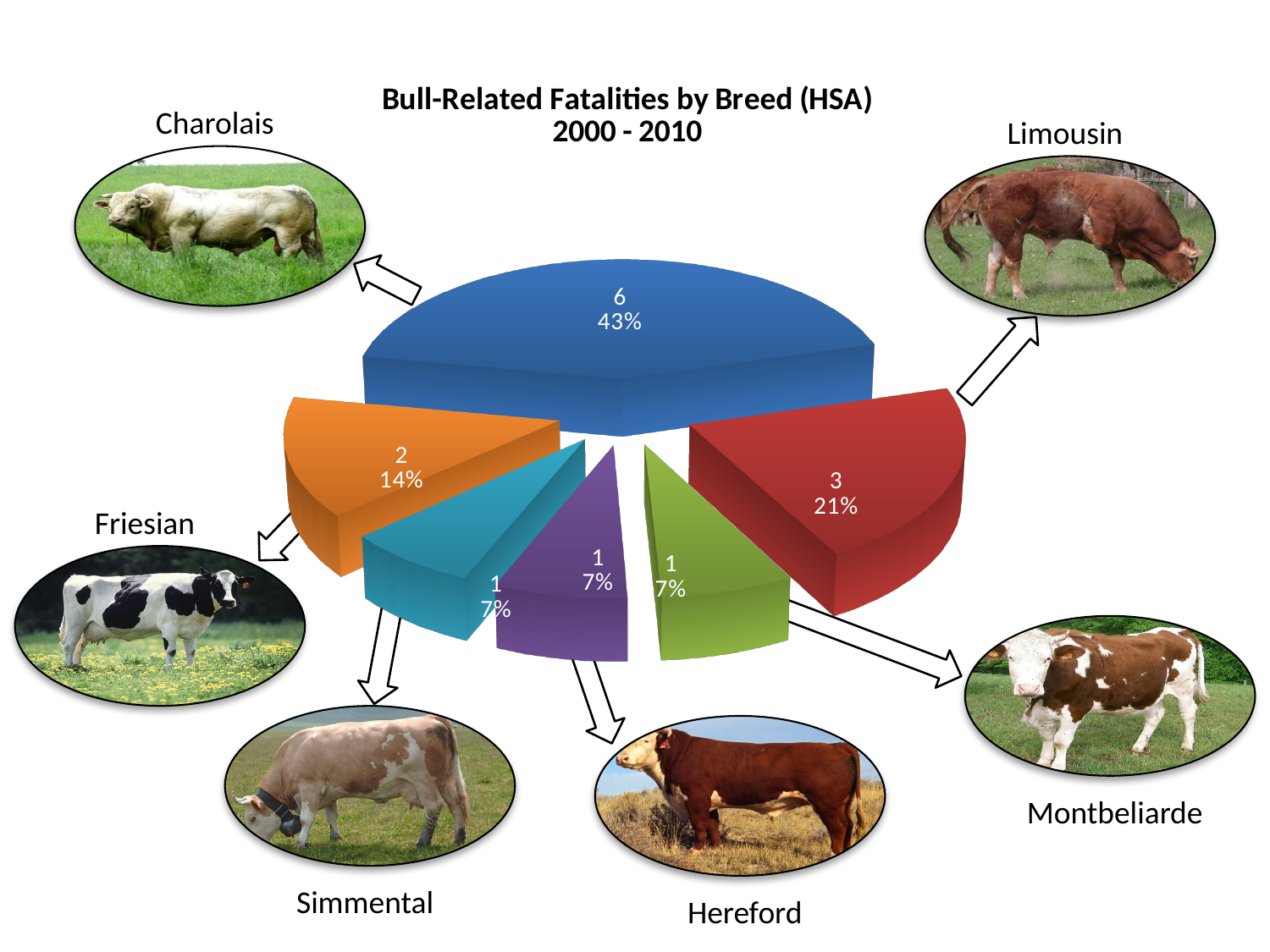
What percentage share of the pie does the Limousin slice represent? 21% How many fatalities are attributed to the Friesian breed? 2 What is the difference in fatalities between Charolais and Limousin? 3 How many fatalities are attributed to the Charolais breed? 6 Which breed has more fatalities, Limousin or Friesian? Limousin How many breeds are shown with 1 fatality (7%)? 3 How many slices does the pie chart have? 6 What is the title of the chart? Bull-Related Fatalities by Breed (HSA) 2000 - 2010 Which breed has the largest slice of the pie? Charolais What is the total number of fatalities across all slices of the pie? 14 What percentage share of the pie does the Charolais slice represent? 43% What kind of chart is shown on the slide? pie chart